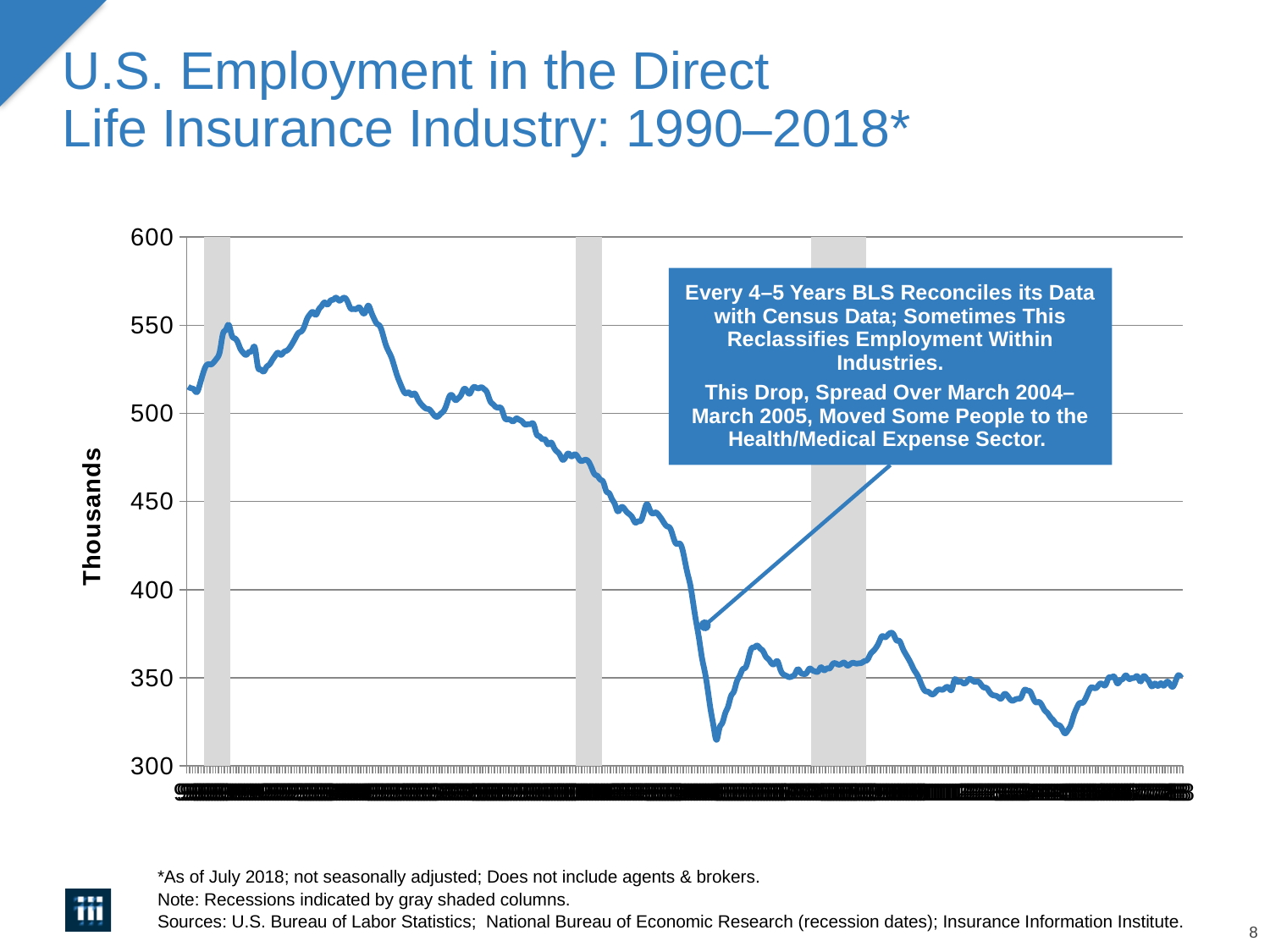
Is the lowest point on the line greater or less than 350? less Is the value at the end of the series (July 2018) greater or less than 400? less What is the lowest value shown on the vertical axis? 300 Is the value at the start of the series (1990) greater or less than 500? greater How many gray shaded recession columns appear on the chart? 3 How many data series are plotted on the chart? 1 What is the title of the chart on the slide? U.S. Employment in the Direct Life Insurance Industry: 1990–2018* Overall, does employment rise or fall from the start of the series in 1990 to the end in 2018? Fall What kind of chart is shown on the slide? Line chart What is the label on the vertical axis of the chart? Thousands